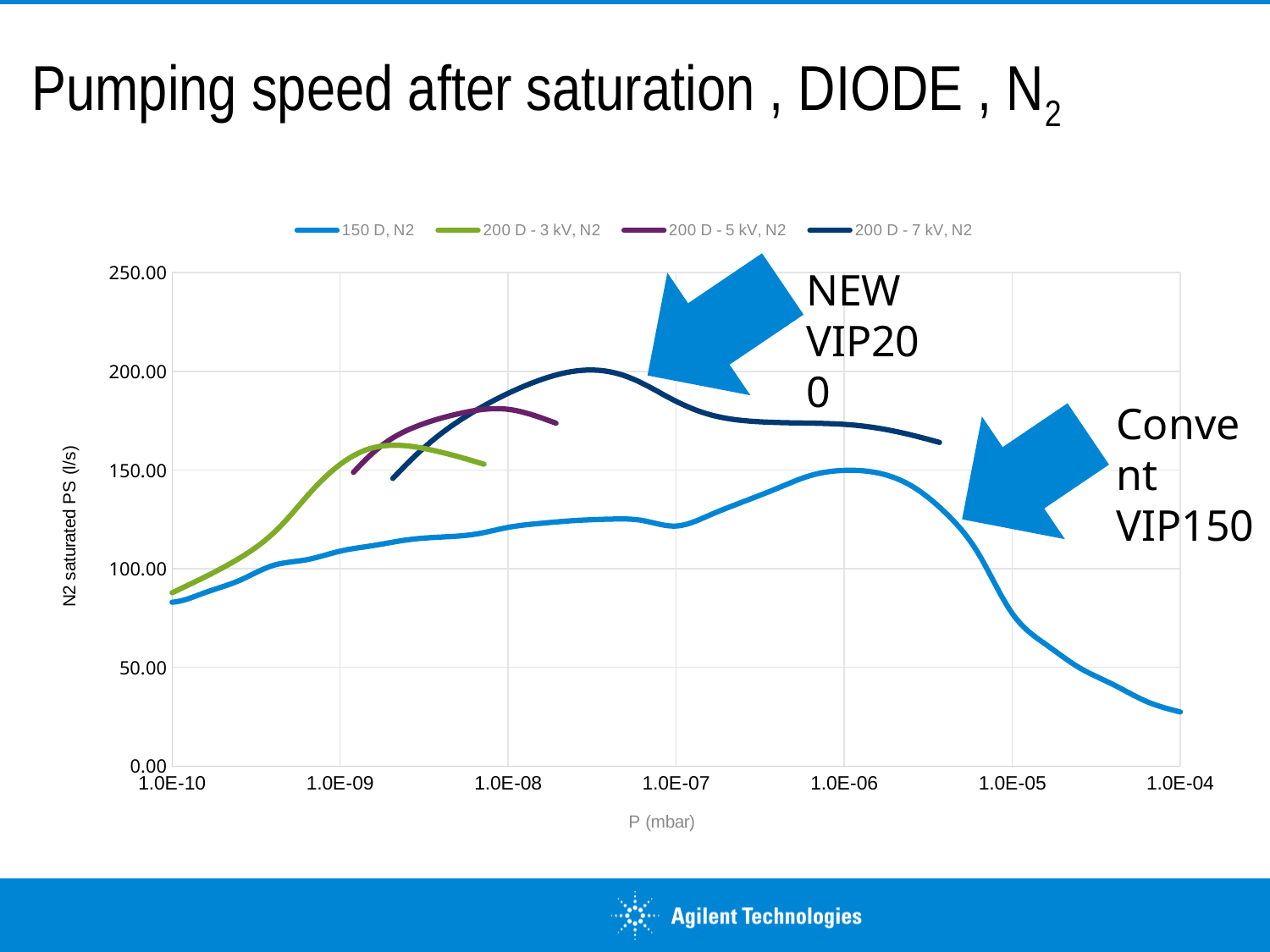
At 1.0E-07 mbar, which series has the larger value: 200 D - 7 kV, N2 or 150 D, N2? 200 D - 7 kV, N2 Is the value for 200 D - 7 kV, N2 at 1.0E-06 mbar greater or less than 150? greater What is the label of the x axis? P (mbar) Is the value for 150 D, N2 at 1.0E-04 mbar greater or less than 50? less What is the label of the y axis? N2 saturated PS (l/s) What kind of chart is shown on the slide? line chart Is the value for 150 D, N2 at 1.0E-10 mbar greater or less than 100? less Does the 150 D, N2 series rise or fall between 1.0E-06 and 1.0E-04 mbar? fall Which series reaches the highest pumping speed on the chart? 200 D - 7 kV, N2 How many series does the legend list? 4